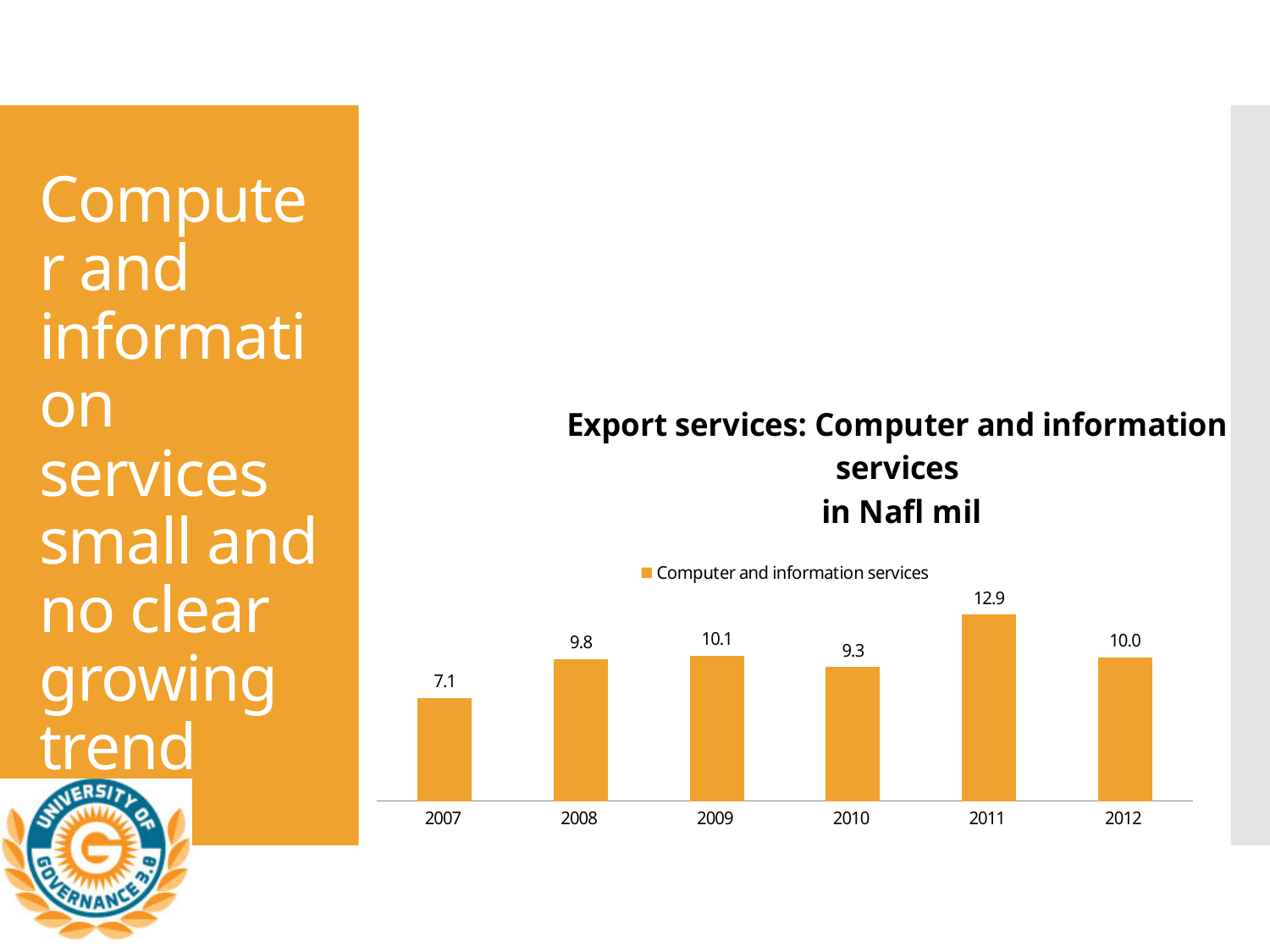
What is the difference between the values for 2009 and 2010? 0.8 Which year has the highest value? 2011 What is the difference between the values for 2011 and 2007? 5.8 What is the title of the chart? Export services: Computer and information services in Nafl mil Which year has the lowest value? 2007 What kind of chart is shown? bar chart What is the value for 2011? 12.9 How many years are shown on the x axis? 6 What is the value for 2010? 9.3 Which is larger, the value for 2008 or the value for 2012? 2012 What is the value for 2007? 7.1 How many series does the legend list? 1